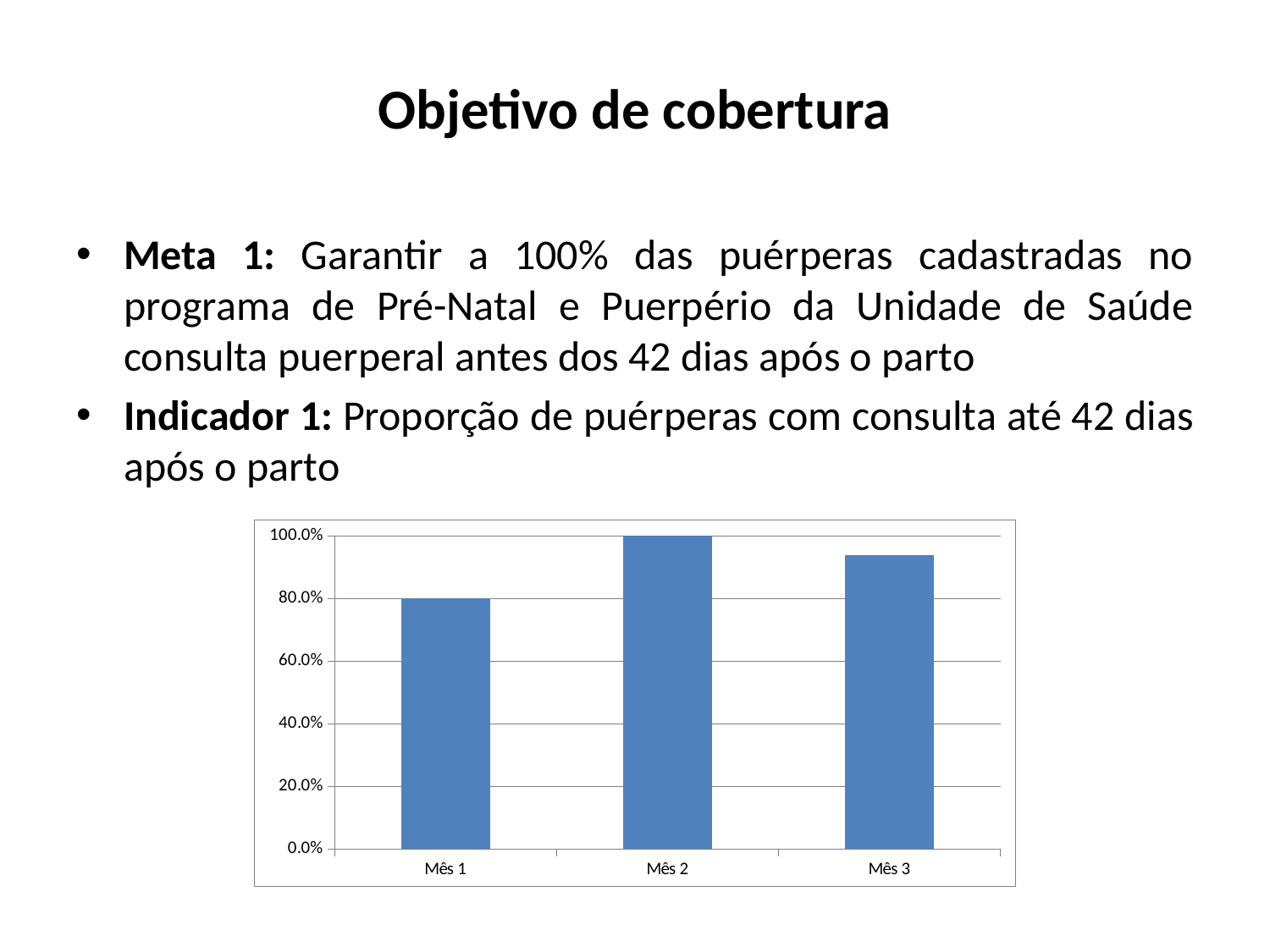
What is the highest tick label on the y axis of the chart? 100.0% Is the value for Mês 3 greater or less than 100.0%? less Which month has the highest value? Mês 2 Does the value rise or fall from Mês 1 to Mês 2? rise What is the value for Mês 1? 80.0% How many categories are shown on the x axis of the chart? 3 Which month has the lowest value? Mês 1 What kind of chart is shown on the slide? bar chart Which is larger, the value for Mês 1 or the value for Mês 3? Mês 3 What is the difference between the values for Mês 2 and Mês 1? 20.0% Is the value for Mês 3 greater or less than 80.0%? greater What is the value for Mês 2? 100.0%